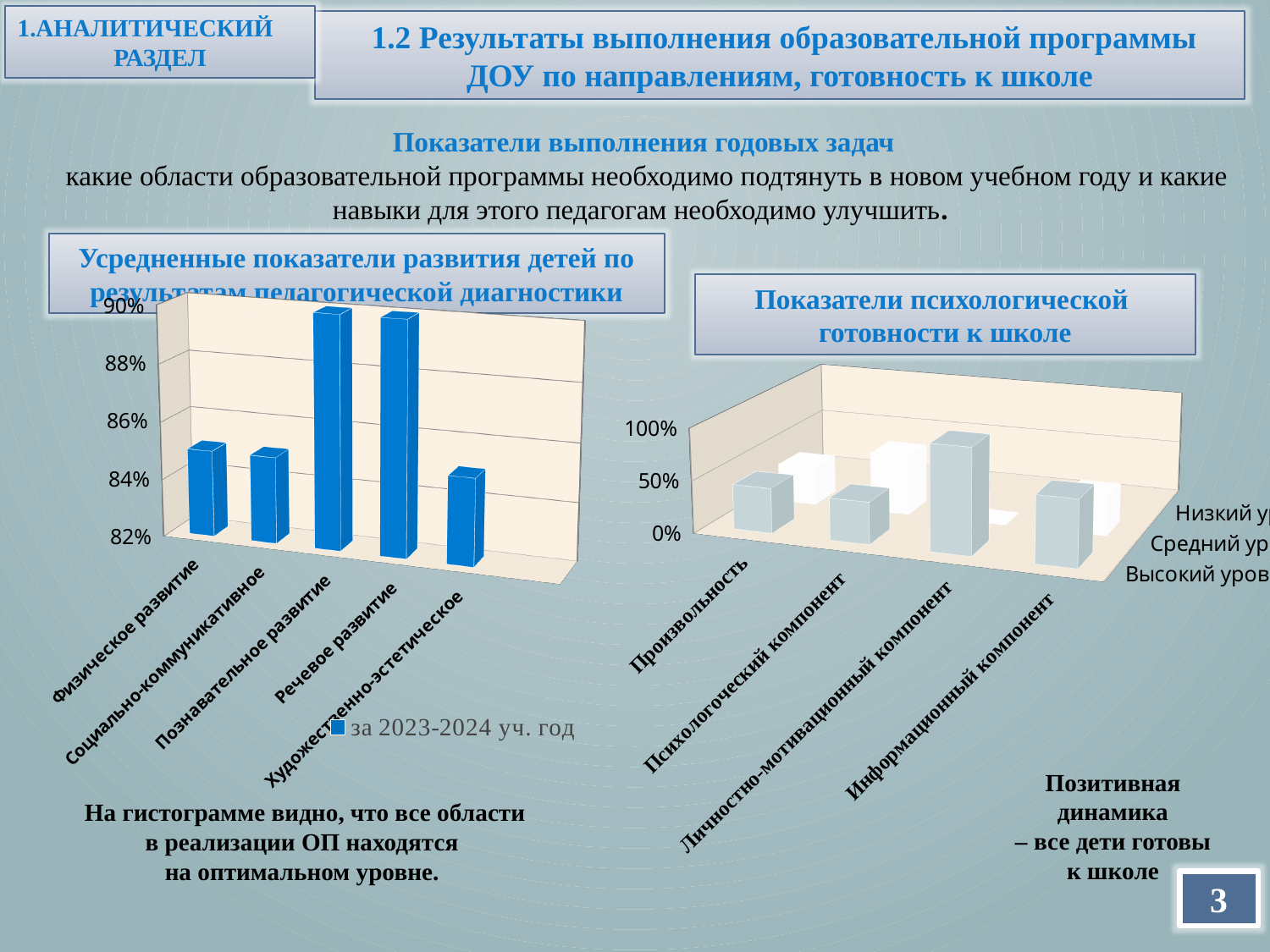
What kind of chart is the left chart, 'Усредненные показатели развития детей по результатам педагогической диагностики'? Bar chart How many series does the legend of the left chart, 'Усредненные показатели развития детей по результатам педагогической диагностики', list? 1 On the left chart, 'Усредненные показатели развития детей по результатам педагогической диагностики', is the value for Физическое развитие greater or less than 86%? less How many categories are shown on the right chart, 'Показатели психологической готовности к школе'? 4 On the left chart, 'Усредненные показатели развития детей по результатам педагогической диагностики', is the value for Познавательное развитие greater or less than 88%? greater How many series are shown on the right chart, 'Показатели психологической готовности к школе'? 3 On the left chart, 'Усредненные показатели развития детей по результатам педагогической диагностики', is the value for Художественно-эстетическое greater or less than 86%? less On the left chart, 'Усредненные показатели развития детей по результатам педагогической диагностики', which is larger: Речевое развитие or Социально-коммуникативное? Речевое развитие How many categories are shown on the left chart, 'Усредненные показатели развития детей по результатам педагогической диагностики'? 5 What kind of chart is the right chart, 'Показатели психологической готовности к школе'? Bar chart On the left chart, 'Усредненные показатели развития детей по результатам педагогической диагностики', what is the legend entry? за 2023-2024 уч. год